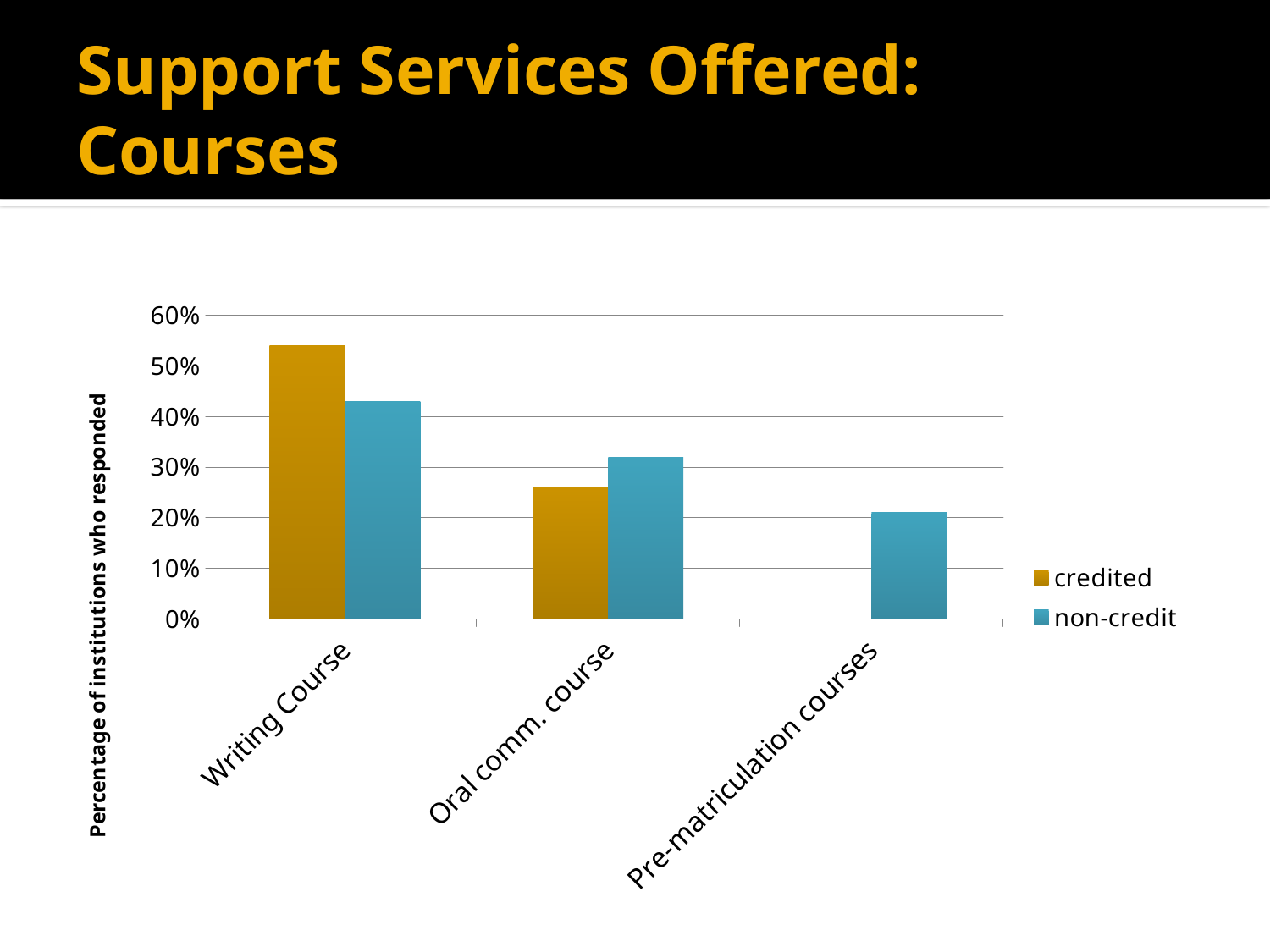
Is the credited value for Oral comm. course greater or less than 30%? less For Oral comm. course, which is larger: the credited or the non-credit value? non-credit What kind of chart is shown on the slide? bar chart How many series does the legend list? 2 What is the label on the vertical axis? Percentage of institutions who responded Which course category has the highest credited value? Writing Course Which course category has the lowest non-credit value? Pre-matriculation courses How many course categories are shown on the x axis? 3 Is the credited value for Writing Course greater or less than 50%? greater For Writing Course, which is larger: the credited or the non-credit value? credited Is the non-credit value for Writing Course greater or less than 40%? greater